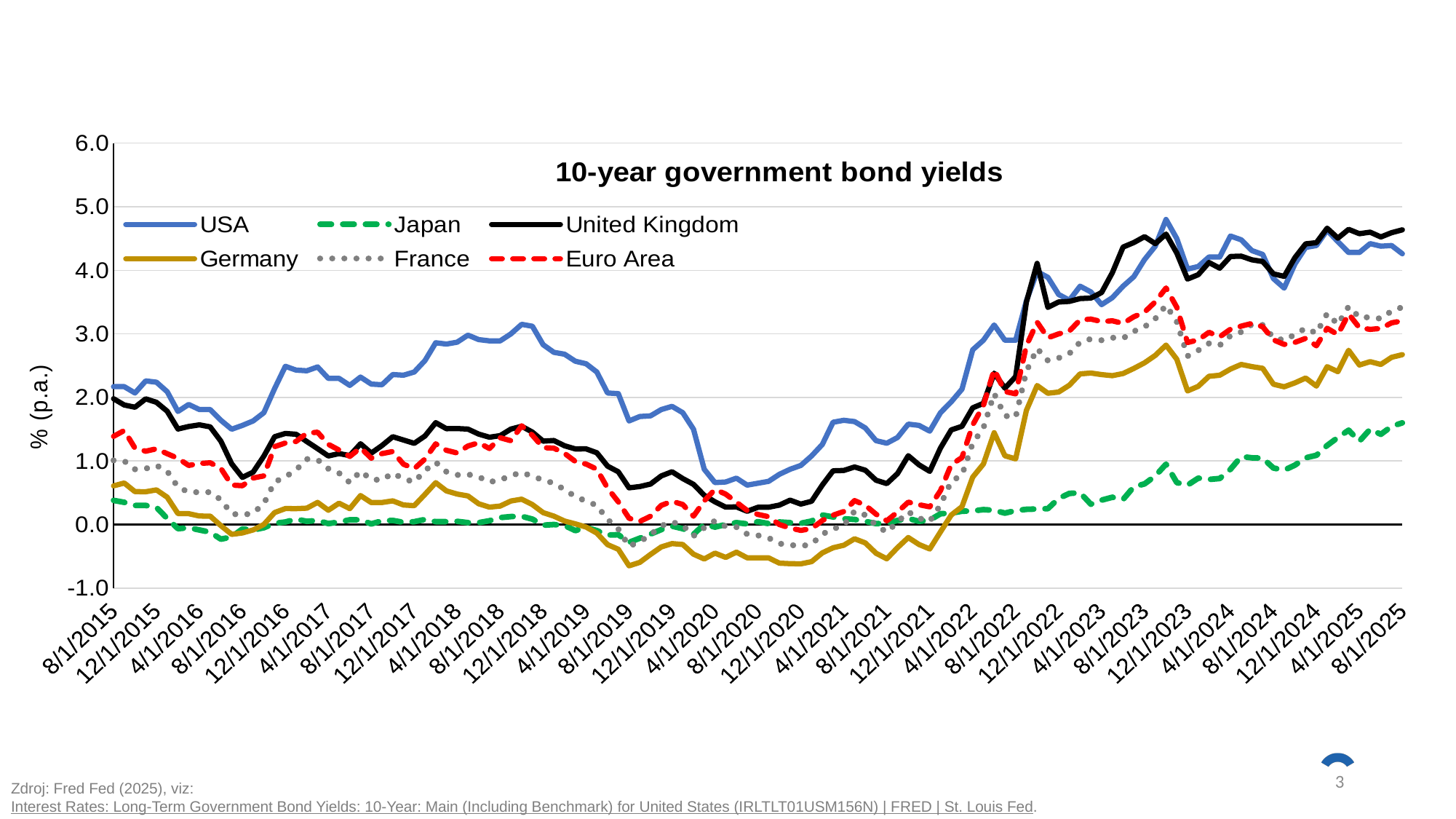
Is the value for Germany at 8/1/2025 greater or less than 3.0? less At 8/1/2025, which series has the higher value, United Kingdom or Germany? United Kingdom Is the value for USA at 8/1/2025 greater or less than 4.0? greater What is the title of the chart? 10-year government bond yields Does the Germany series rise or fall between 8/1/2021 and 8/1/2022? rise Is the value for Japan at 8/1/2025 greater or less than 2.0? less Which series has the lowest value at 8/1/2025? Japan Which series has the highest value at 8/1/2025? United Kingdom How many series does the legend of the chart list? 6 What is the label on the vertical axis of the chart? % (p.a.) What kind of chart is shown on the slide? line chart